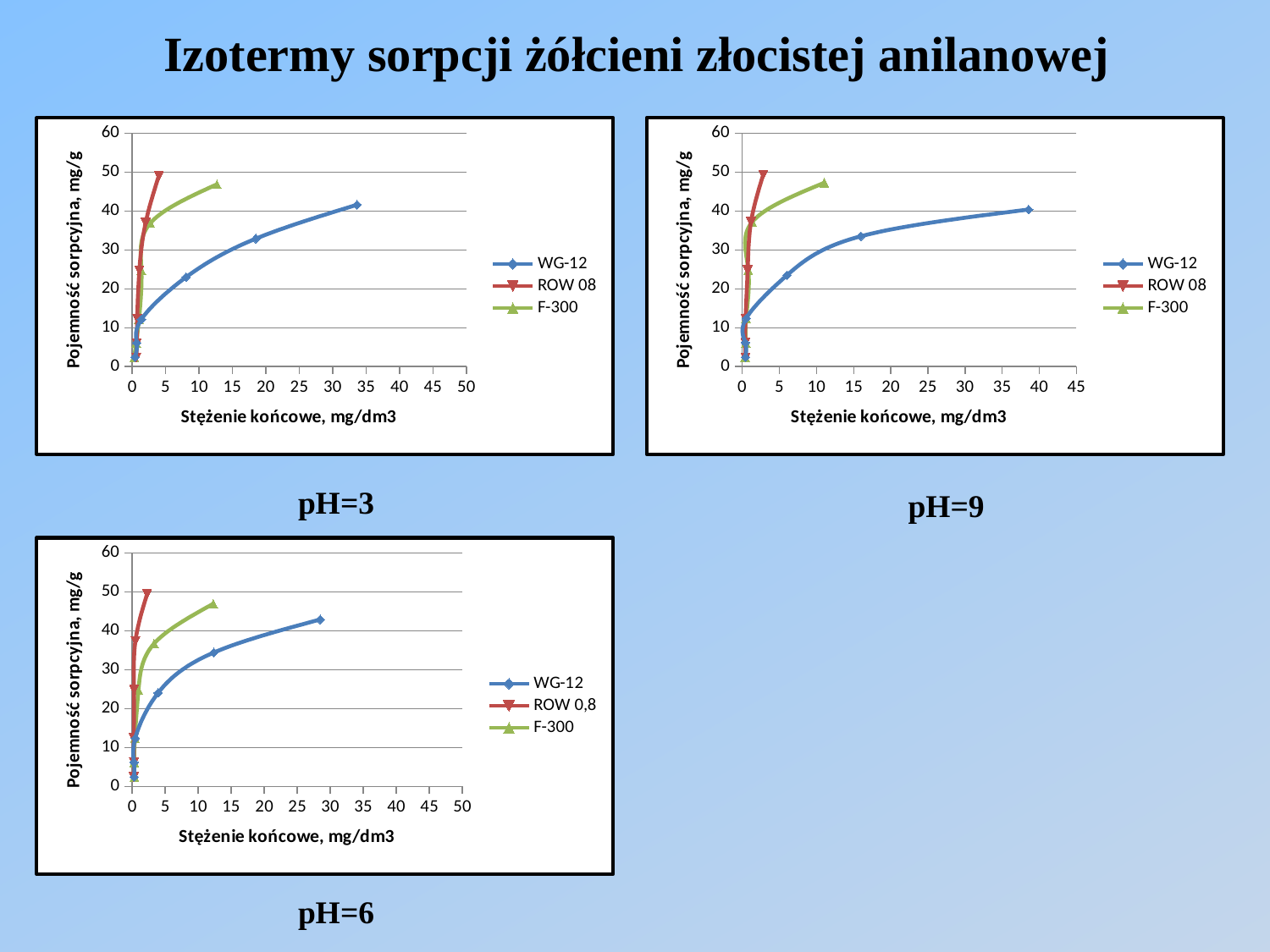
In the pH=9 chart, what kind of chart is it? line chart In the pH=3 chart, does the WG-12 series rise or fall as the final concentration increases? rise In the pH=9 chart, which series reaches the lowest maximum sorption capacity? WG-12 How many charts are shown on the slide? 3 In the pH=3 chart, how many series does the legend list? 3 In the pH=9 chart, is the highest sorption capacity reached by the F-300 series greater or less than 40? greater In the pH=3 chart, which series extends to the highest final concentration on the x axis? WG-12 In the pH=6 chart, is the highest sorption capacity reached by the WG-12 series greater or less than 35? greater In the pH=6 chart, which series reaches a higher final concentration, WG-12 or F-300? WG-12 In the pH=6 chart, what are the series names listed in the legend? WG-12, ROW 0,8, F-300 What is the x-axis title of the pH=9 chart? Stężenie końcowe, mg/dm3 In the pH=3 chart, is the highest sorption capacity reached by the WG-12 series greater or less than 35? greater